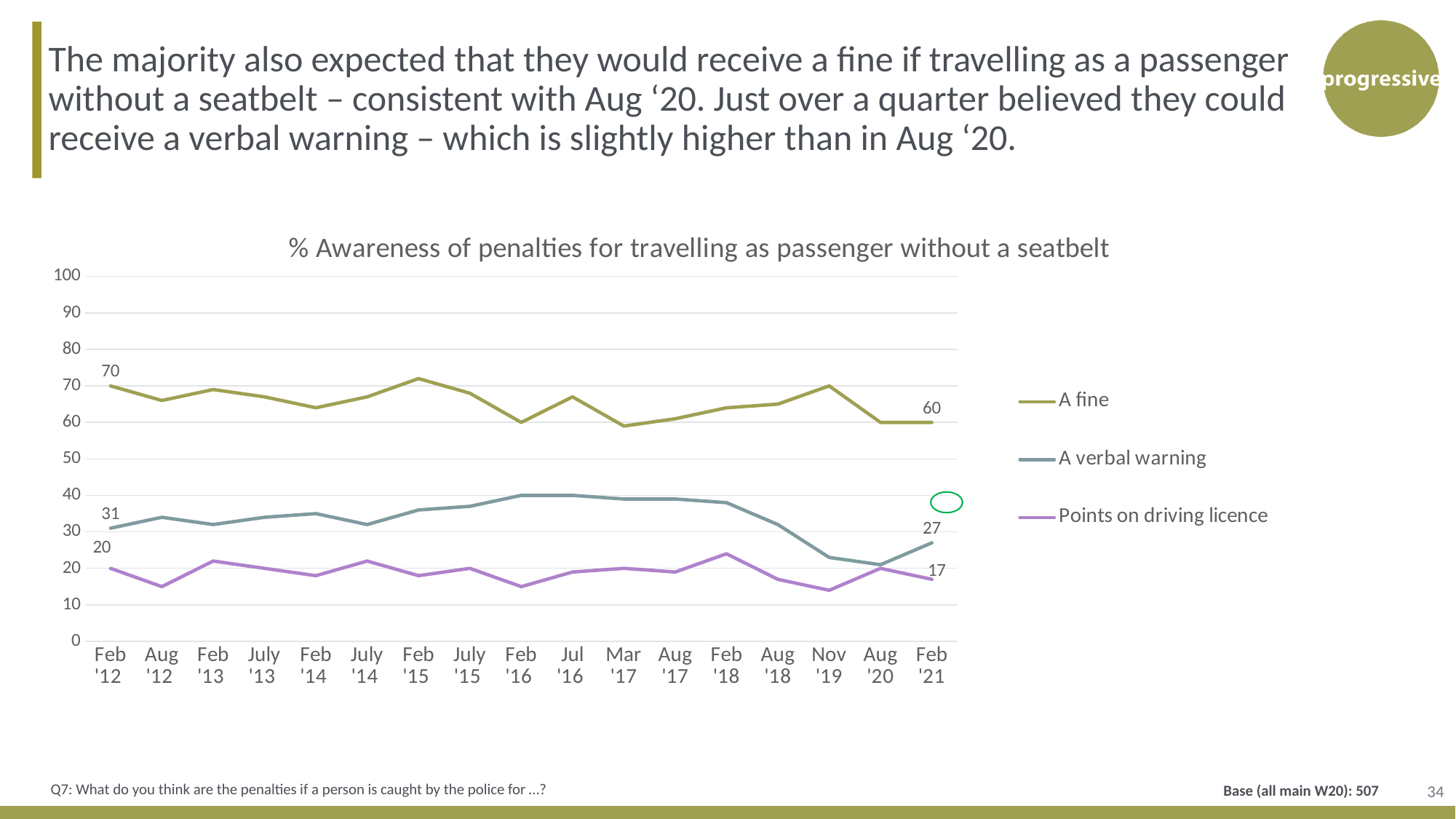
Which series has the highest value in Feb '21? A fine What is the value for Points on driving licence in Feb '12? 20 In Feb '21, which is larger: A verbal warning or Points on driving licence? A verbal warning What is the value for A fine in Feb '12? 70 What is the difference between A verbal warning in Feb '12 and in Feb '21? 4 How many time points are shown on the x axis? 17 What is the value for A verbal warning in Feb '21? 27 What is the value for Points on driving licence in Feb '21? 17 What kind of chart is shown on the slide? Line chart How many series does the legend list? 3 Is the value for A verbal warning in Nov '19 greater or less than 30? less By how much did the value for A fine fall between Feb '12 and Feb '21? 10